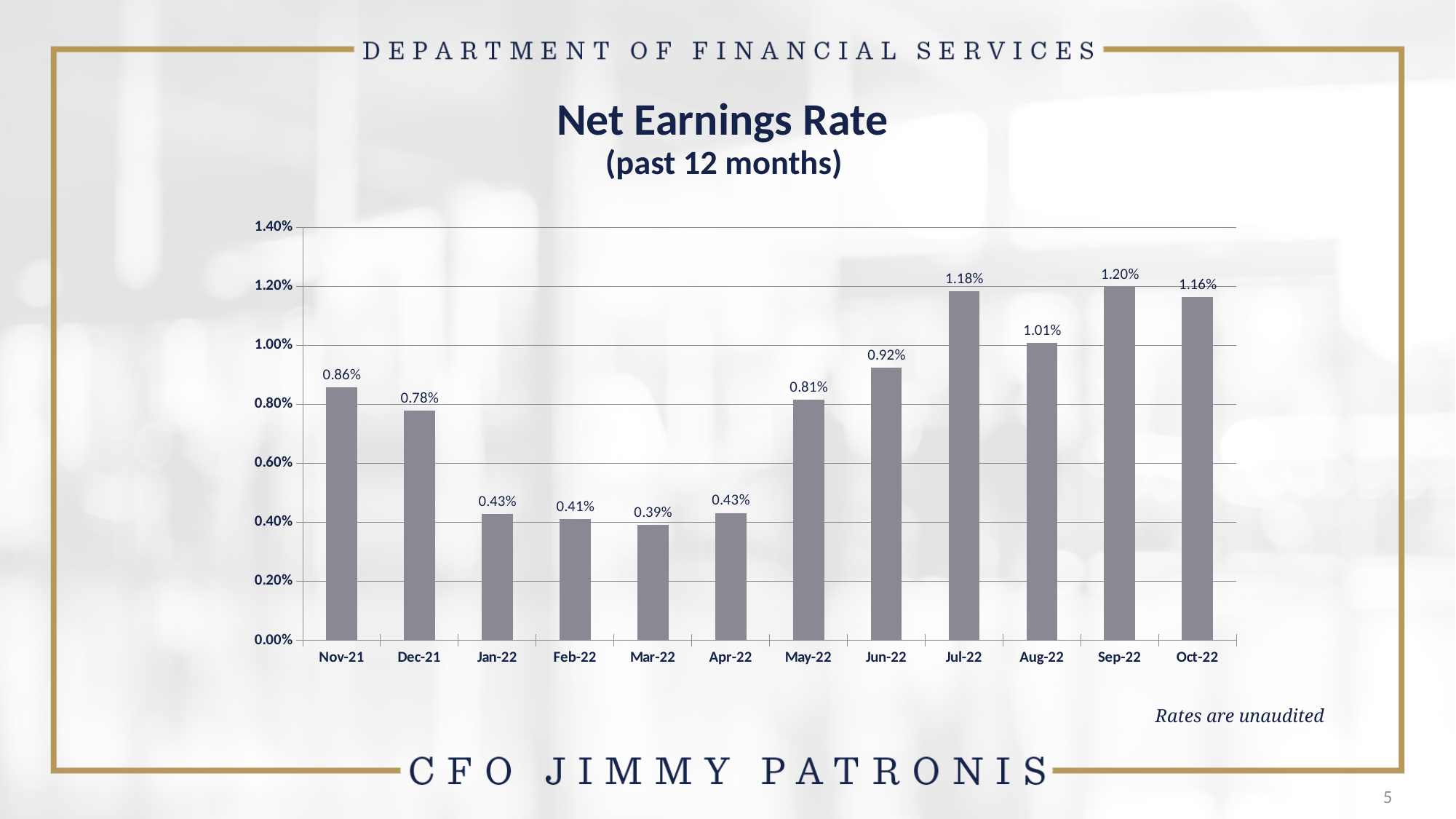
How many months are shown on the chart? 12 Which is larger, the net earnings rate for Jul-22 or Aug-22? Jul-22 What is the title of the chart? Net Earnings Rate (past 12 months) Do the net earnings rates rise or fall from Apr-22 to Jul-22? Rise What is the net earnings rate for Mar-22? 0.39% What is the net earnings rate for Sep-22? 1.20% What is the difference between the net earnings rate for Sep-22 and Mar-22? 0.81% Is the net earnings rate for Jun-22 greater or less than 1.00%? less Which month has the lowest net earnings rate? Mar-22 What kind of chart is shown on the slide? Bar chart Which month has the highest net earnings rate? Sep-22 What is the net earnings rate for Nov-21? 0.86%